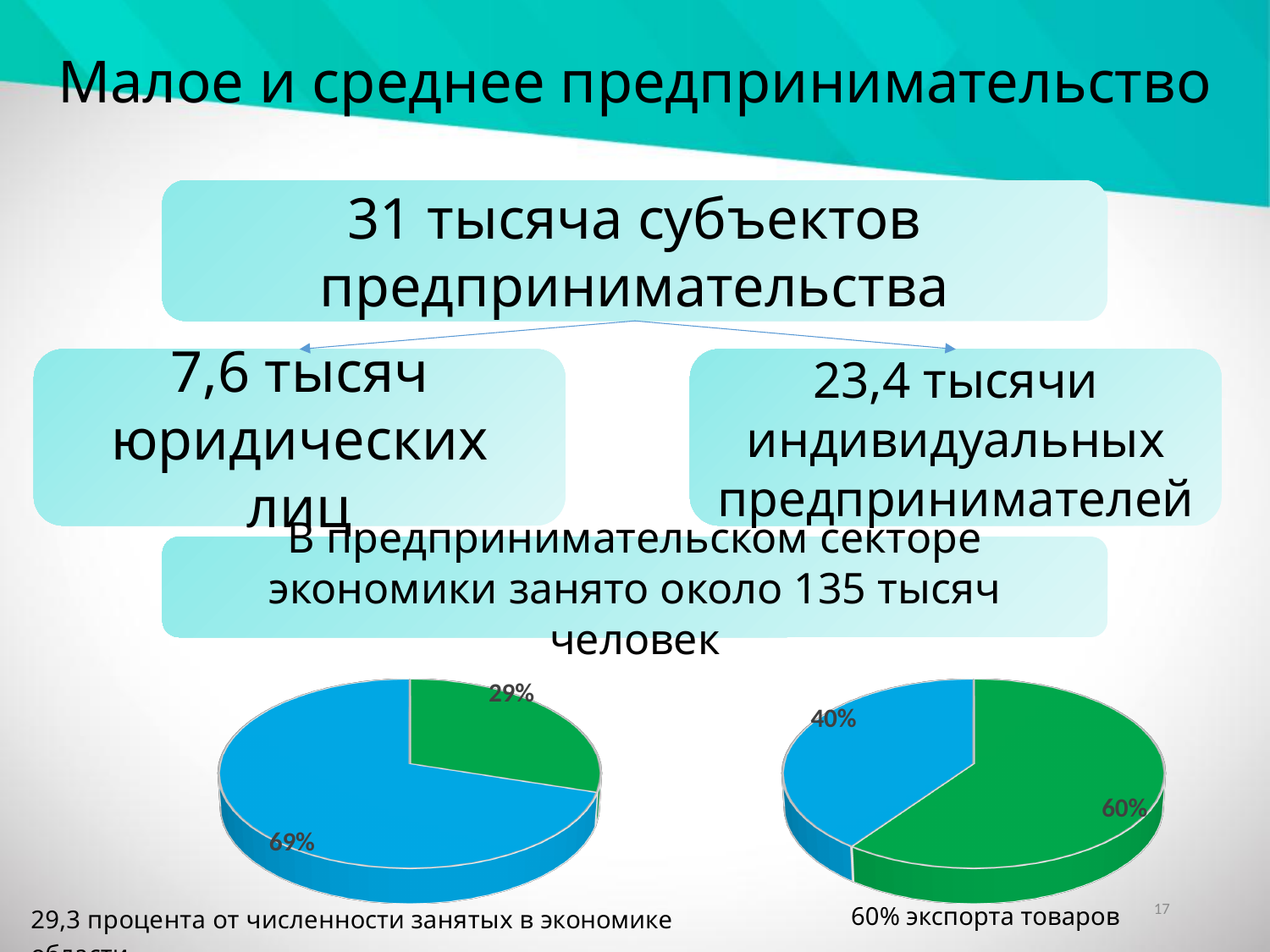
In the right pie chart, what percentage is shown on the blue slice? 40% In the left pie chart, what percentage is shown on the blue slice? 69% In the right pie chart, what is the difference between the green slice and the blue slice? 20% What caption is printed below the right pie chart? 60% экспорта товаров What kind of chart is the right chart on the slide? pie chart How many slices does the right pie chart have? 2 How many slices does the left pie chart have? 2 In the right pie chart, which slice is larger, the blue one or the green one? the green one In the right pie chart, what percentage is shown on the green slice? 60% In the left pie chart, which slice is larger, the blue one or the green one? the blue one What kind of chart is the left chart on the slide? pie chart In the left pie chart, what percentage is shown on the green slice? 29%